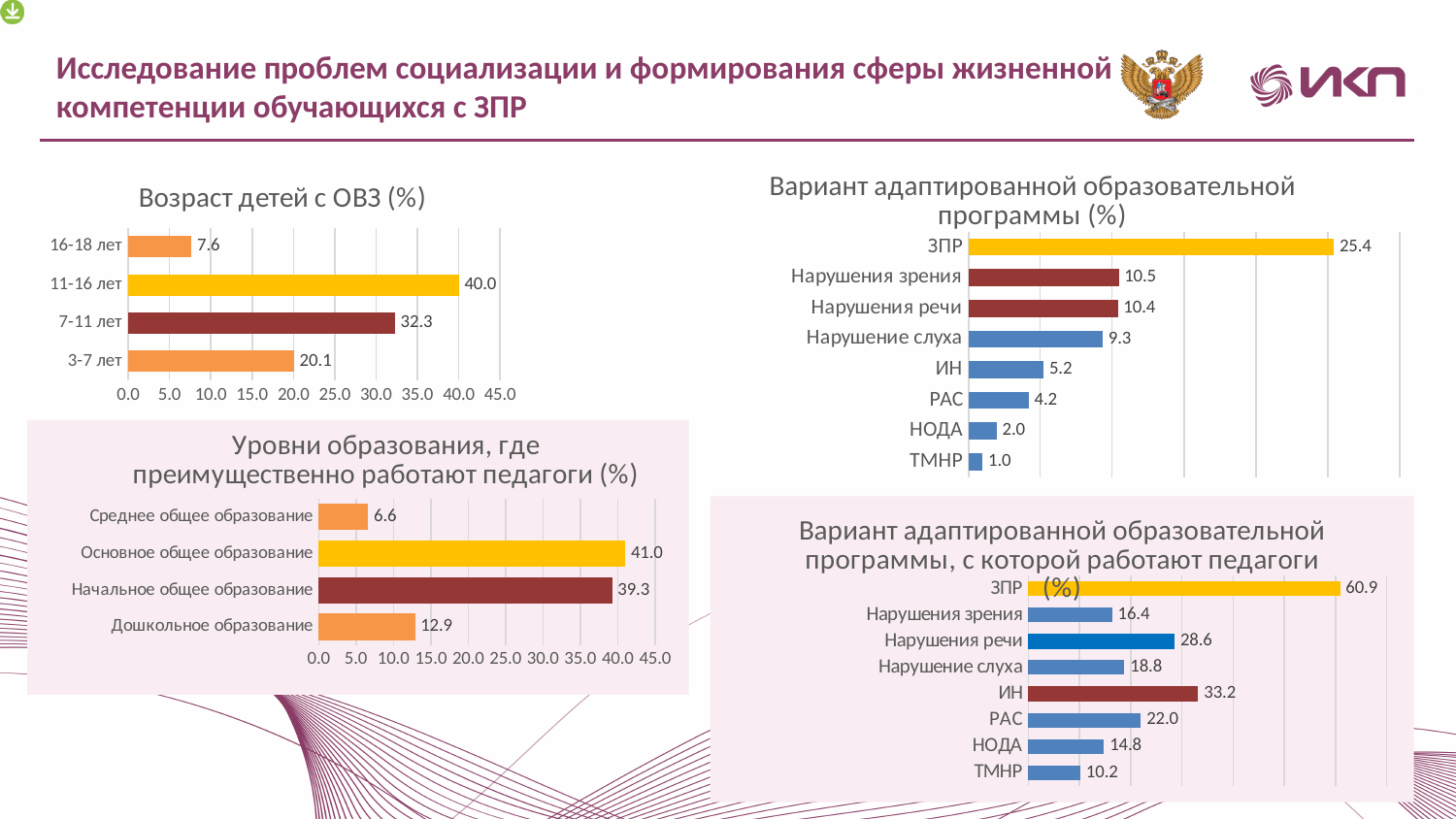
In the chart titled "Вариант адаптированной образовательной программы (%)" (top right), what is the value for Нарушение слуха? 9.3 In the chart titled "Возраст детей с ОВЗ (%)", what is the difference between the values for 7-11 лет and 3-7 лет? 12.2 In the chart titled "Уровни образования, где преимущественно работают педагоги (%)", what is the value for Дошкольное образование? 12.9 In the chart titled "Вариант адаптированной образовательной программы (%)" (top right), which category has the lowest value? ТМНР In the chart titled "Возраст детей с ОВЗ (%)", what is the value for 11-16 лет? 40.0 What type of chart is the chart titled "Возраст детей с ОВЗ (%)"? Bar chart In the bottom-right chart titled "Вариант адаптированной образовательной программы, с которой работают педагоги (%)", which is larger: Нарушения речи or РАС? Нарушения речи In the bottom-right chart titled "Вариант адаптированной образовательной программы, с которой работают педагоги (%)", what is the value for ИН? 33.2 In the chart titled "Уровни образования, где преимущественно работают педагоги (%)", which category has the highest value? Основное общее образование In the chart titled "Возраст детей с ОВЗ (%)", which age group has the lowest value? 16-18 лет In the chart titled "Уровни образования, где преимущественно работают педагоги (%)", how many categories are shown? 4 In the chart titled "Вариант адаптированной образовательной программы (%)" (top right), how many categories are shown? 8